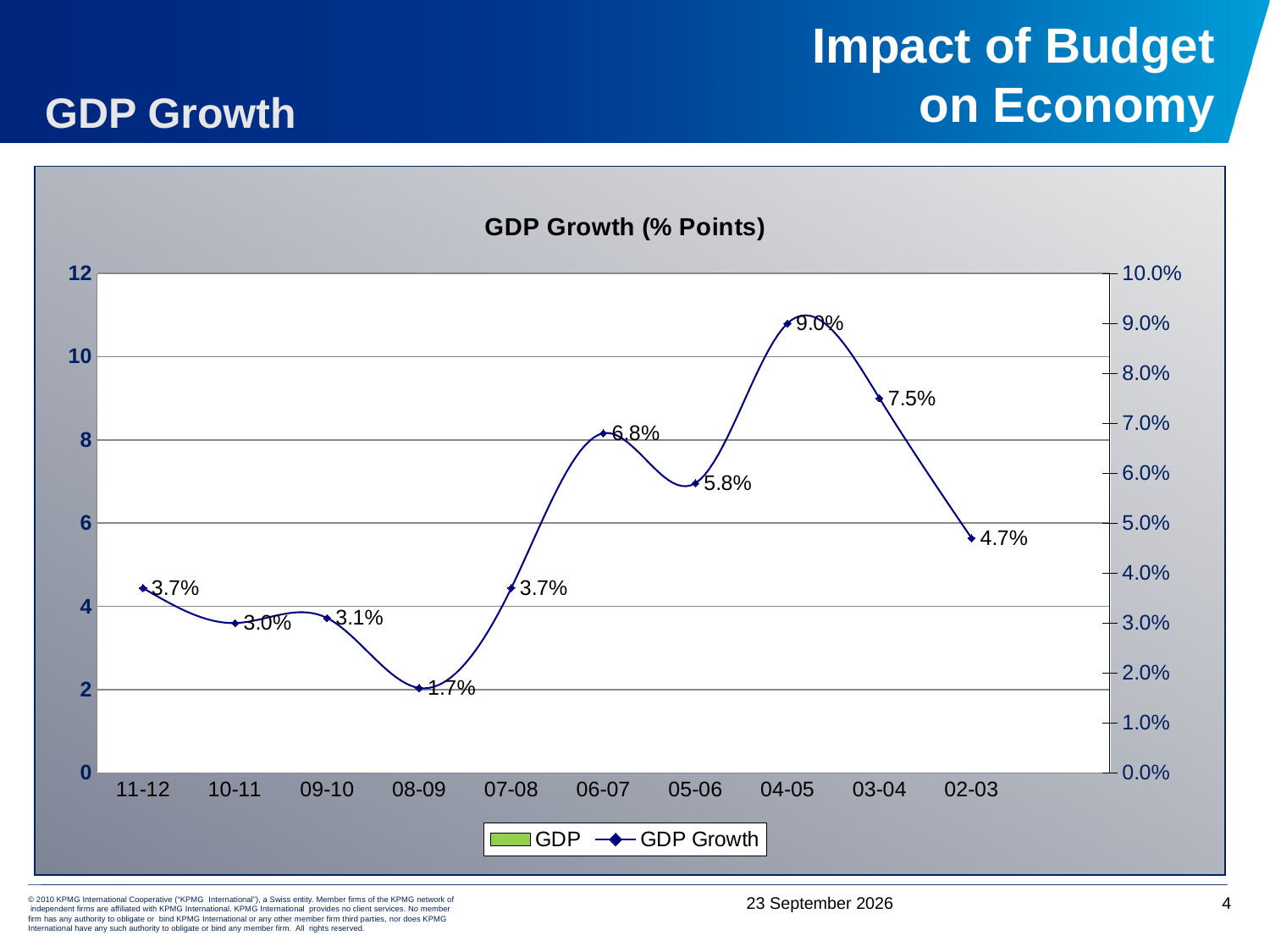
Which is larger, the GDP Growth for 06-07 or for 05-06? 06-07 Which year has the lowest GDP Growth? 08-09 What is the title of the chart? GDP Growth (% Points) What is the GDP Growth value for 08-09? 1.7% Which year has the highest GDP Growth? 04-05 What is the difference between the GDP Growth values for 04-05 and 08-09? 7.3 percentage points How many series does the chart legend list? 2 How many years are shown on the x axis of the chart? 10 What is the GDP Growth value for 02-03? 4.7% What is the GDP Growth value for 10-11? 3.0% What is the GDP Growth value for 04-05? 9.0% What is the difference between the GDP Growth values for 03-04 and 02-03? 2.8 percentage points